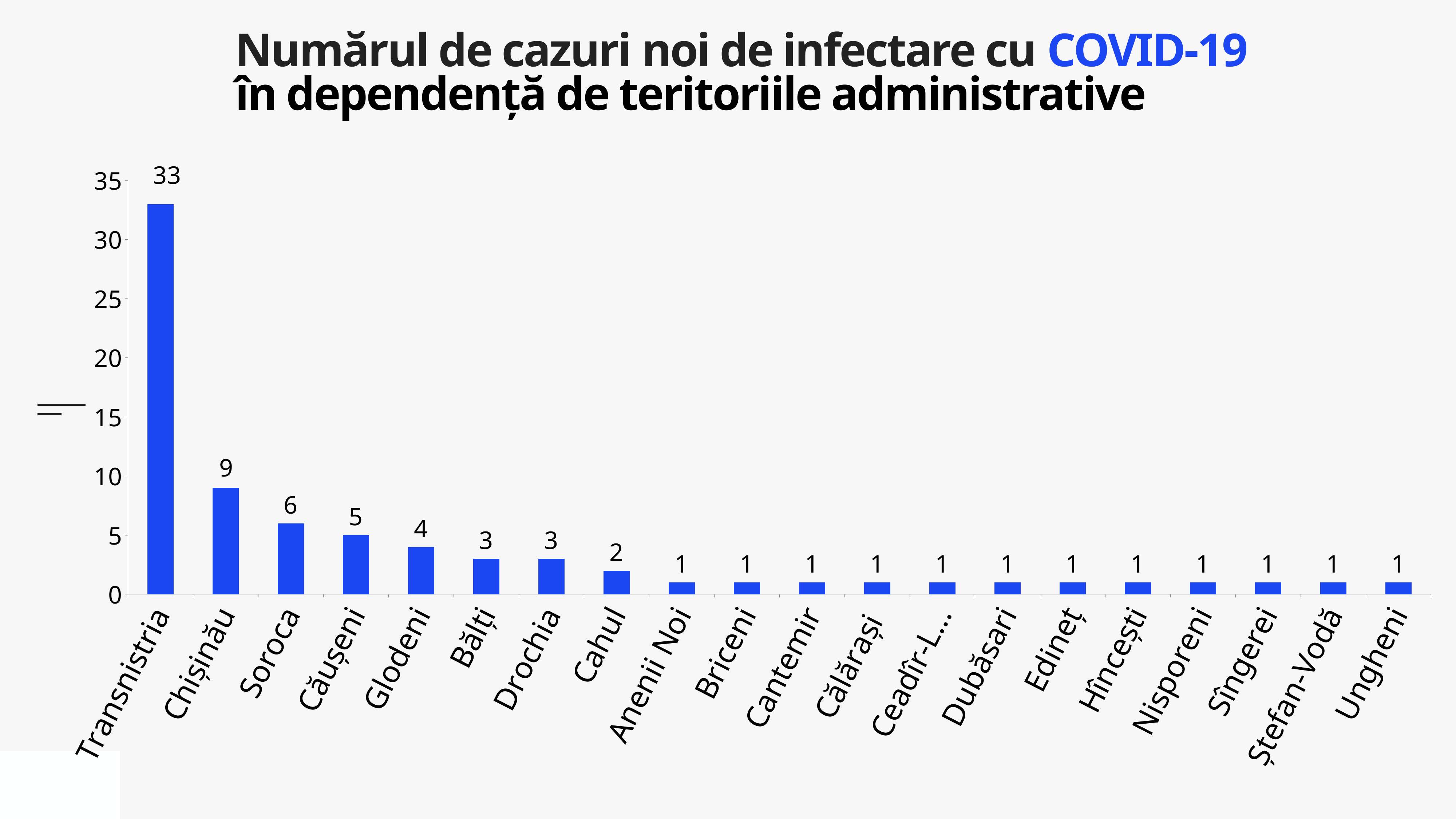
What kind of chart is shown on the slide? bar chart What is the difference between the values for Soroca and Căușeni? 1 What is the value for Glodeni? 4 What is the value for Transnistria? 33 What is the value for Chișinău? 9 Which is larger, the value for Bălți or the value for Cahul? Bălți What is the value for Cahul? 2 Which category has the highest value? Transnistria Is the value for Transnistria greater or less than 30? greater What is the difference between the values for Transnistria and Chișinău? 24 How many categories are shown on the x axis? 20 What is the value for Soroca? 6